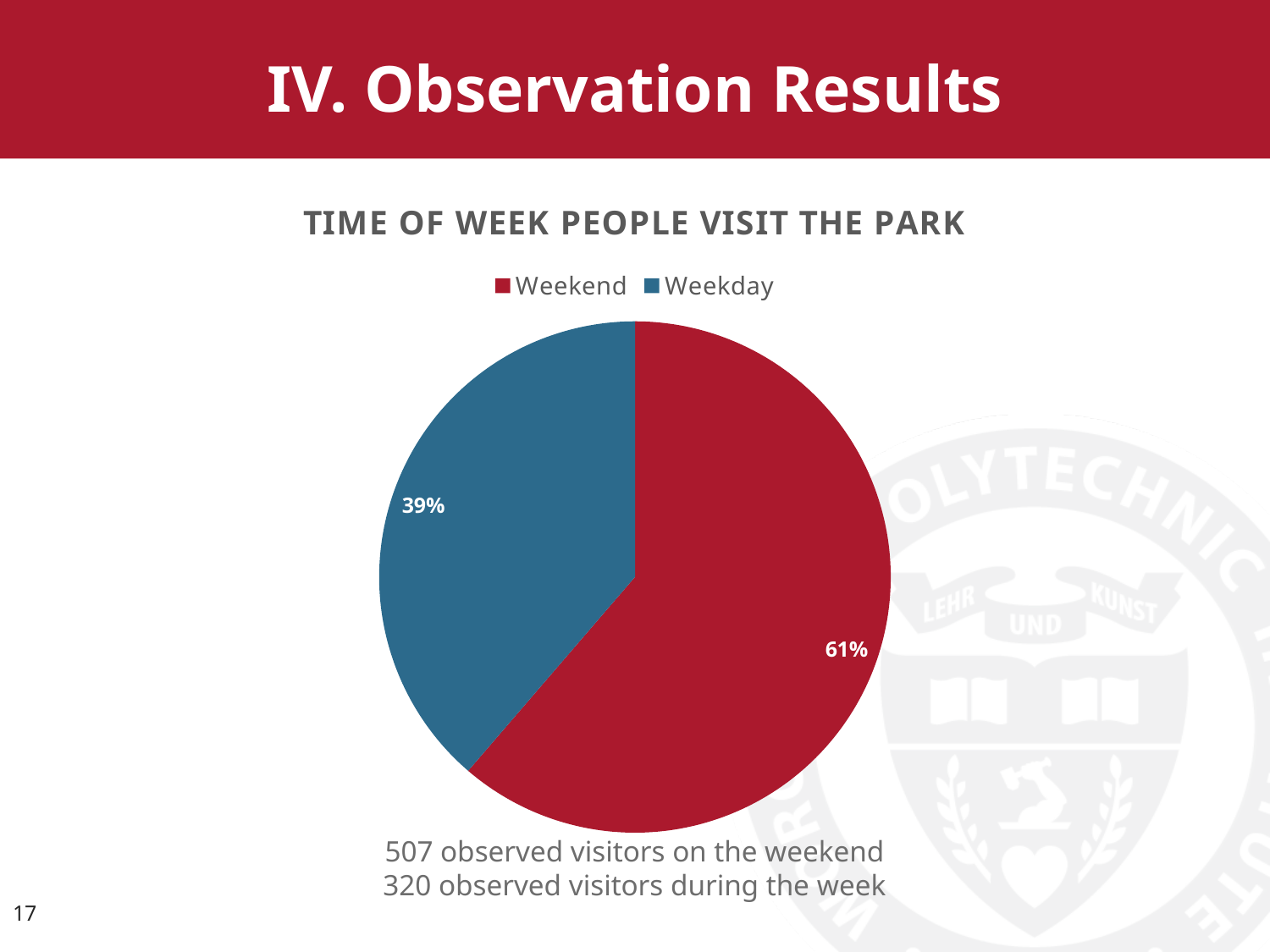
What colour is the Weekday slice? blue What is the difference in percentage points between the Weekend and Weekday slices? 22 What kind of chart is shown on the slide? pie chart Is the Weekday share greater or less than 50%? less Which is larger, the Weekend slice or the Weekday slice? Weekend Which slice is the smallest? Weekday What percentage of the pie is the Weekend slice? 61% Which slice is the largest? Weekend How many slices does the pie chart have? 2 What percentage of the pie is the Weekday slice? 39% How many entries does the legend list? 2 What is the title of the chart? TIME OF WEEK PEOPLE VISIT THE PARK